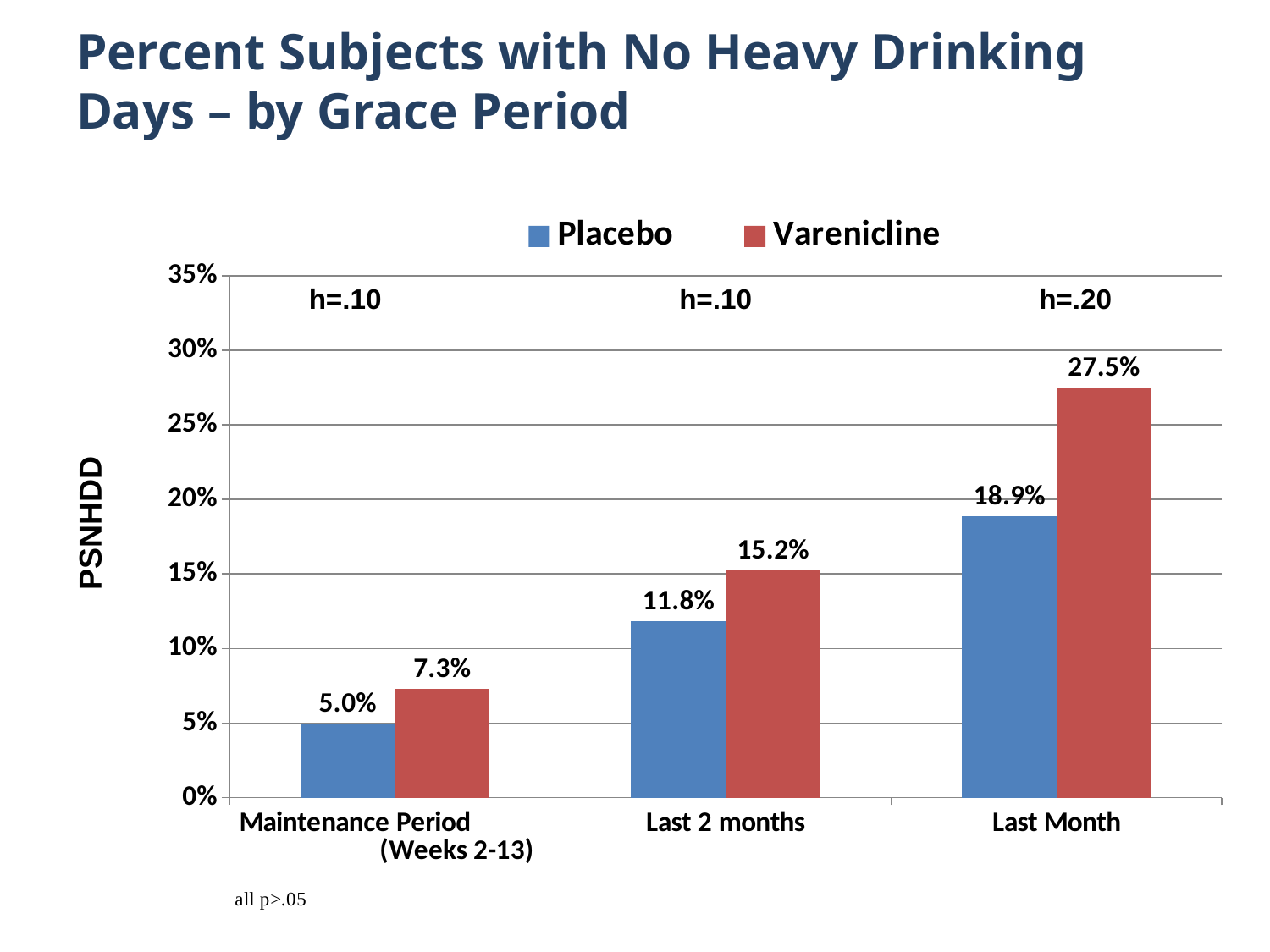
Do the Placebo values rise or fall from Maintenance Period to Last Month? Rise What is the Varenicline value for Last Month? 27.5% How many categories are shown on the x axis? 3 What is the Placebo value for the Maintenance Period (Weeks 2-13)? 5.0% What is the Varenicline value for Last 2 months? 15.2% How many series does the legend list? 2 Which category has the lowest Placebo value? Maintenance Period (Weeks 2-13) What is the difference between the Varenicline and Placebo values for Last Month? 8.6% What is the Placebo value for Last 2 months? 11.8% What kind of chart is this? Bar chart Which is larger for Last 2 months, Placebo or Varenicline? Varenicline Which category has the highest Varenicline value? Last Month